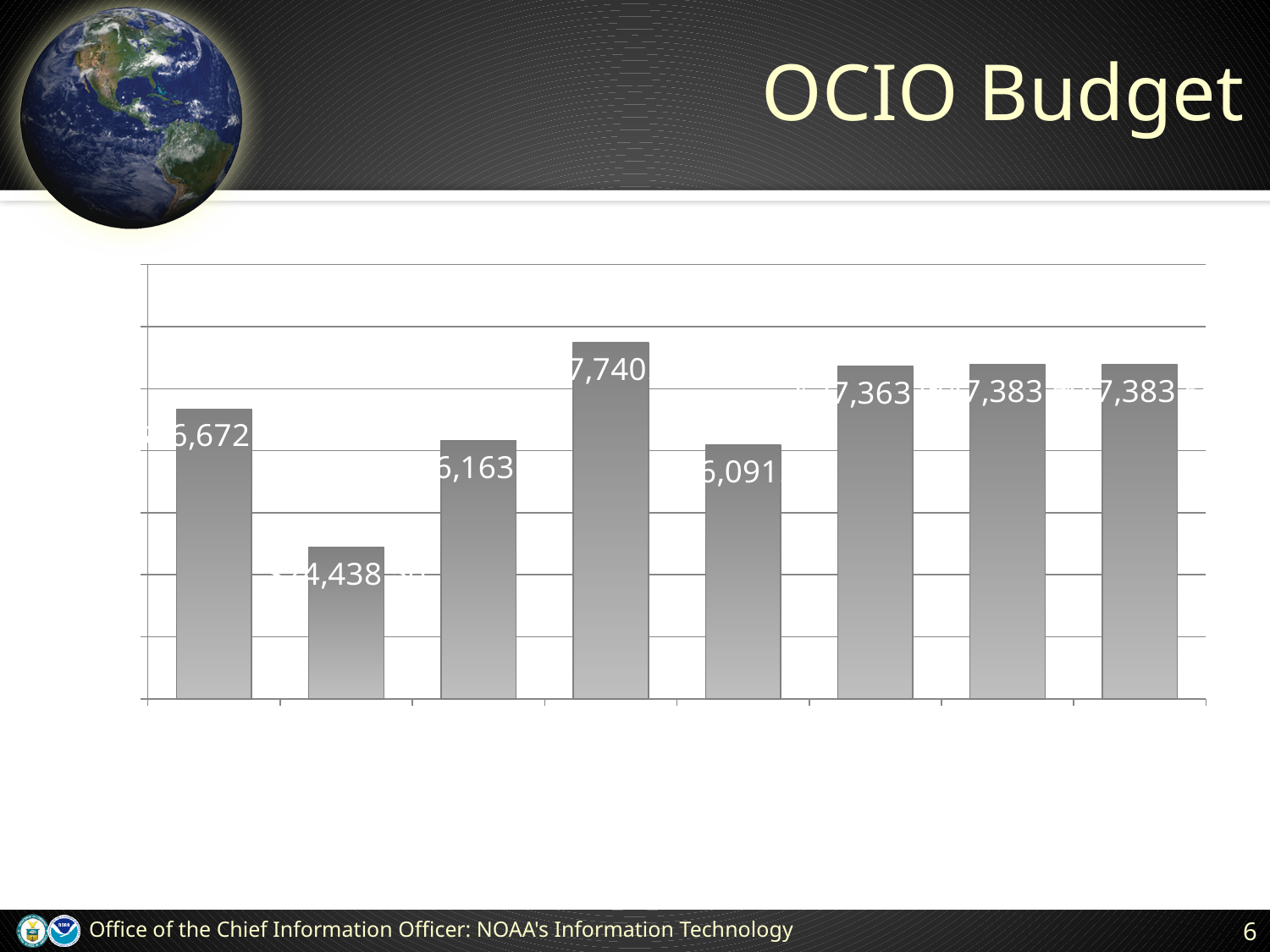
What is the value shown on the fifth bar from the left? $26,091.50 What is the value shown on the first bar from the left? $26,672.00 What is the title of the slide containing the chart? OCIO Budget What kind of chart is shown on the slide? bar chart What is the highest value labelled on any bar in the chart? $27,740.50 How many bars are plotted in the chart? 8 What is the value shown on the last bar on the right? $27,383.50 What is the value shown on the second bar from the left? $24,438.50 What is the lowest value labelled on any bar in the chart? $24,438.50 What is the value shown on the fourth bar from the left? $27,740.50